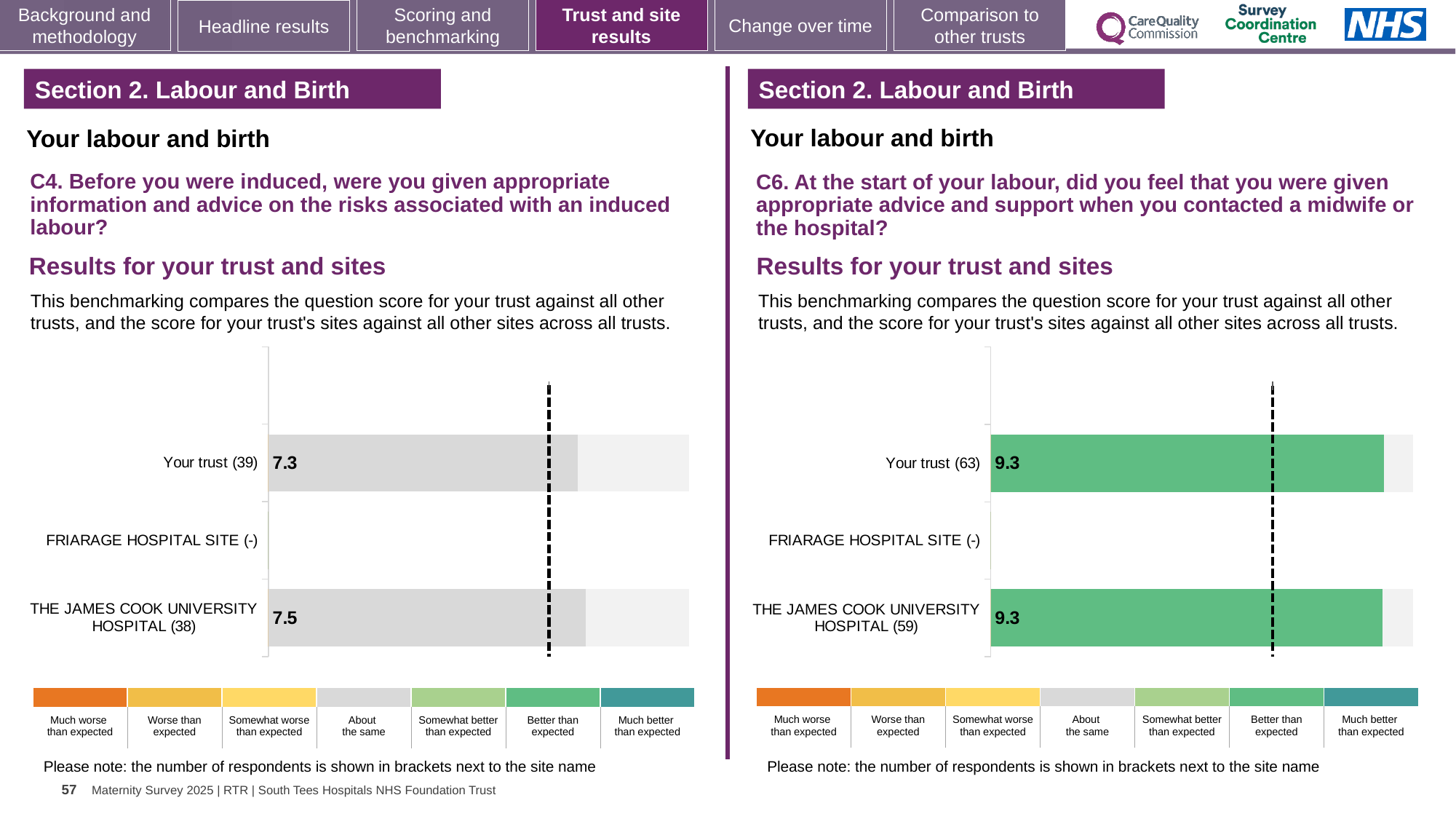
In the C4 chart on the left, what is the difference between the score for THE JAMES COOK UNIVERSITY HOSPITAL and the score for Your trust? 0.2 In the C6 chart on the right, what is the score for THE JAMES COOK UNIVERSITY HOSPITAL? 9.3 In the C4 chart on the left, which is larger: the score for Your trust or for THE JAMES COOK UNIVERSITY HOSPITAL? THE JAMES COOK UNIVERSITY HOSPITAL In the C6 chart on the right, how many respondents are shown in brackets for THE JAMES COOK UNIVERSITY HOSPITAL? 59 In the C4 chart on the left, what is the score for Your trust? 7.3 How many categories (rows) are listed on the y axis of the C4 chart on the left? 3 In the C4 chart on the left, what is the score for THE JAMES COOK UNIVERSITY HOSPITAL? 7.5 In the C6 chart on the right, what is the difference between the score for Your trust and the score for THE JAMES COOK UNIVERSITY HOSPITAL? 0 In the C4 chart on the left, how many respondents are shown in brackets for Your trust? 39 What kind of chart is the C6 chart on the right? Bar chart In the C6 chart on the right, what is the score for Your trust? 9.3